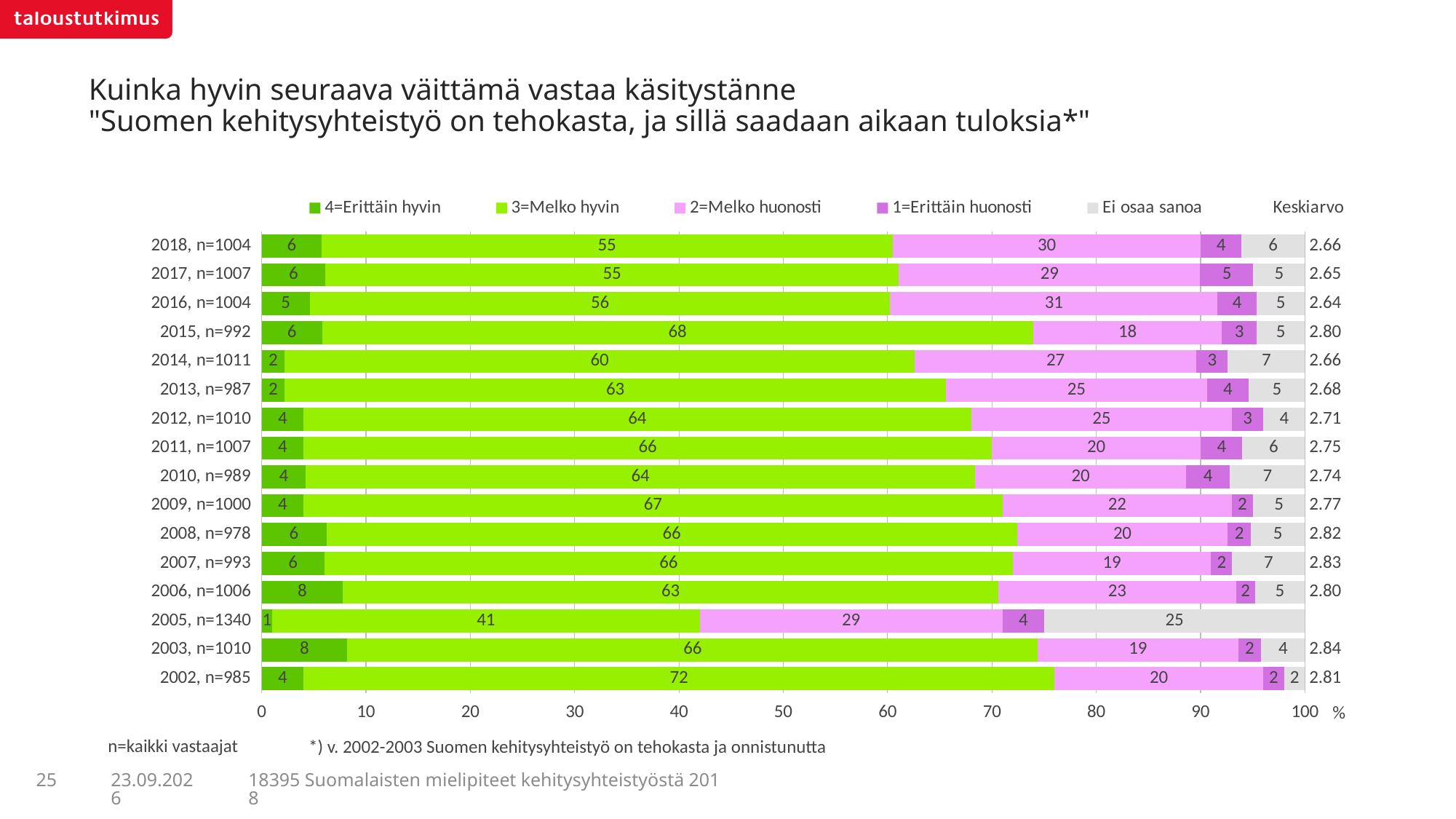
What percentage of respondents in 2018 (n=1004) answered "3=Melko hyvin"? 55 What type of chart is shown on the slide? Stacked bar chart Which year has the lowest "3=Melko hyvin" value? 2005, n=1340 What is the difference between the "3=Melko hyvin" values for 2002 and 2018? 17 How many series does the legend list? 5 How many year categories are shown in the chart? 16 Which year has the larger "3=Melko hyvin" value, 2015 or 2014? 2015, n=992 What is the "2=Melko huonosti" value for 2015 (n=992)? 18 Which year has the lowest Keskiarvo value shown? 2016, n=1004 What is the Keskiarvo (mean) shown for 2003 (n=1010)? 2.84 What is the "Ei osaa sanoa" share for 2005 (n=1340)? 25 Which year has the highest "3=Melko hyvin" value? 2002, n=985